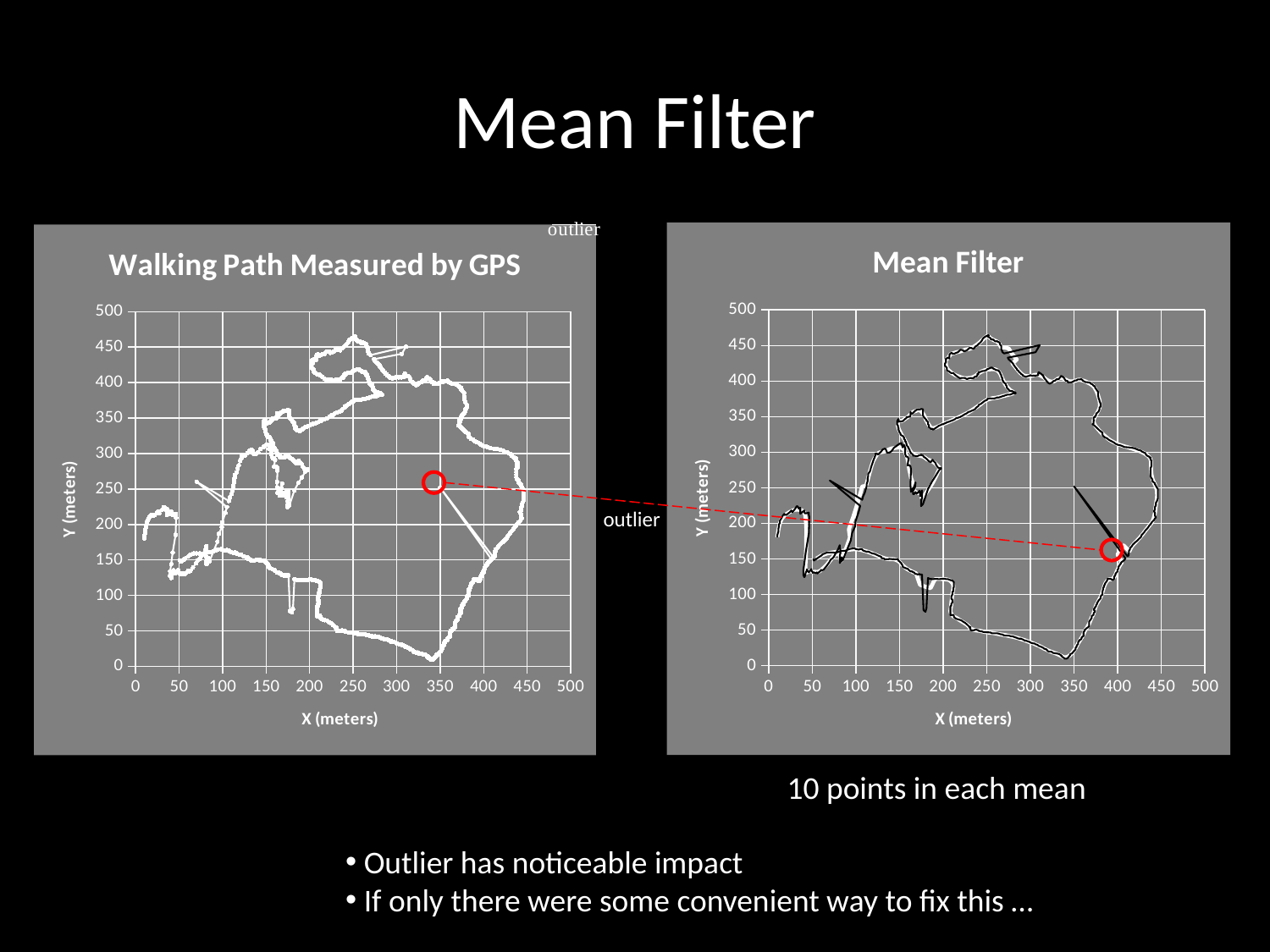
What kind of chart is the right chart titled 'Mean Filter'? scatter chart What kind of chart is the left chart titled 'Walking Path Measured by GPS'? scatter chart In the left chart 'Walking Path Measured by GPS', is the Y value of the circled outlier point greater or less than 200? greater In the left chart 'Walking Path Measured by GPS', is the X value of the circled outlier point greater or less than 250? greater What is the title of the left chart? Walking Path Measured by GPS In the right chart 'Mean Filter', is the X value of the circled point greater or less than 300? greater In the right chart titled 'Mean Filter', what is the label on the x axis? X (meters)